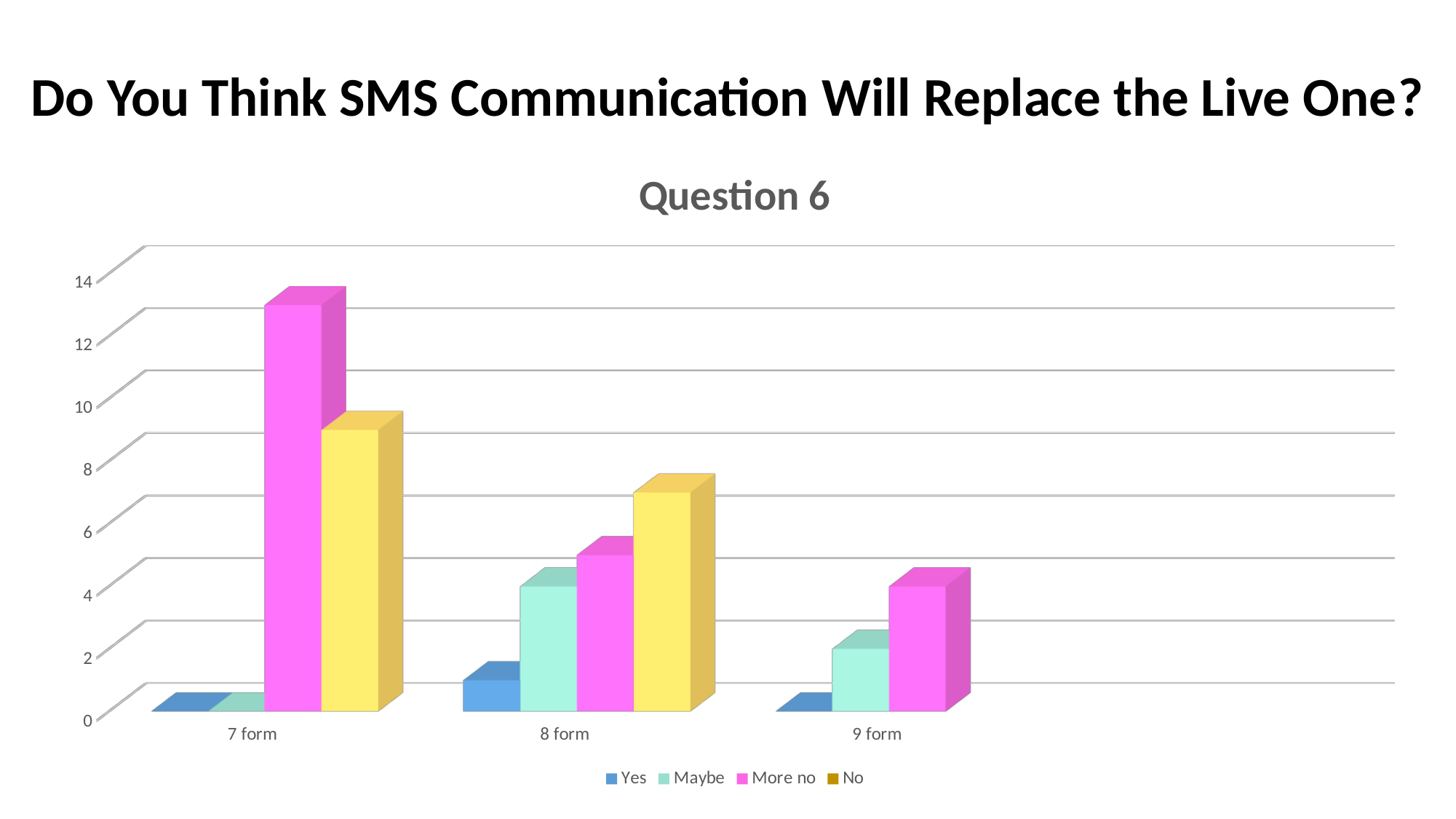
Does the value for More no rise or fall from 7 form to 9 form? fall How many series does the legend list? 4 Is the value for No in 7 form greater or less than 10? less Which series has the highest value for 9 form? More no Is the value for No in 8 form greater or less than 6? greater Is the value for More no in 7 form greater or less than 12? greater What is the title of the chart? Question 6 Which series has the tallest bar in the whole chart? More no What kind of chart is shown on the slide? bar chart How many categories are shown on the x axis? 3 For 8 form, which is larger: the value for No or the value for More no? No Which series has the highest value for 8 form? No